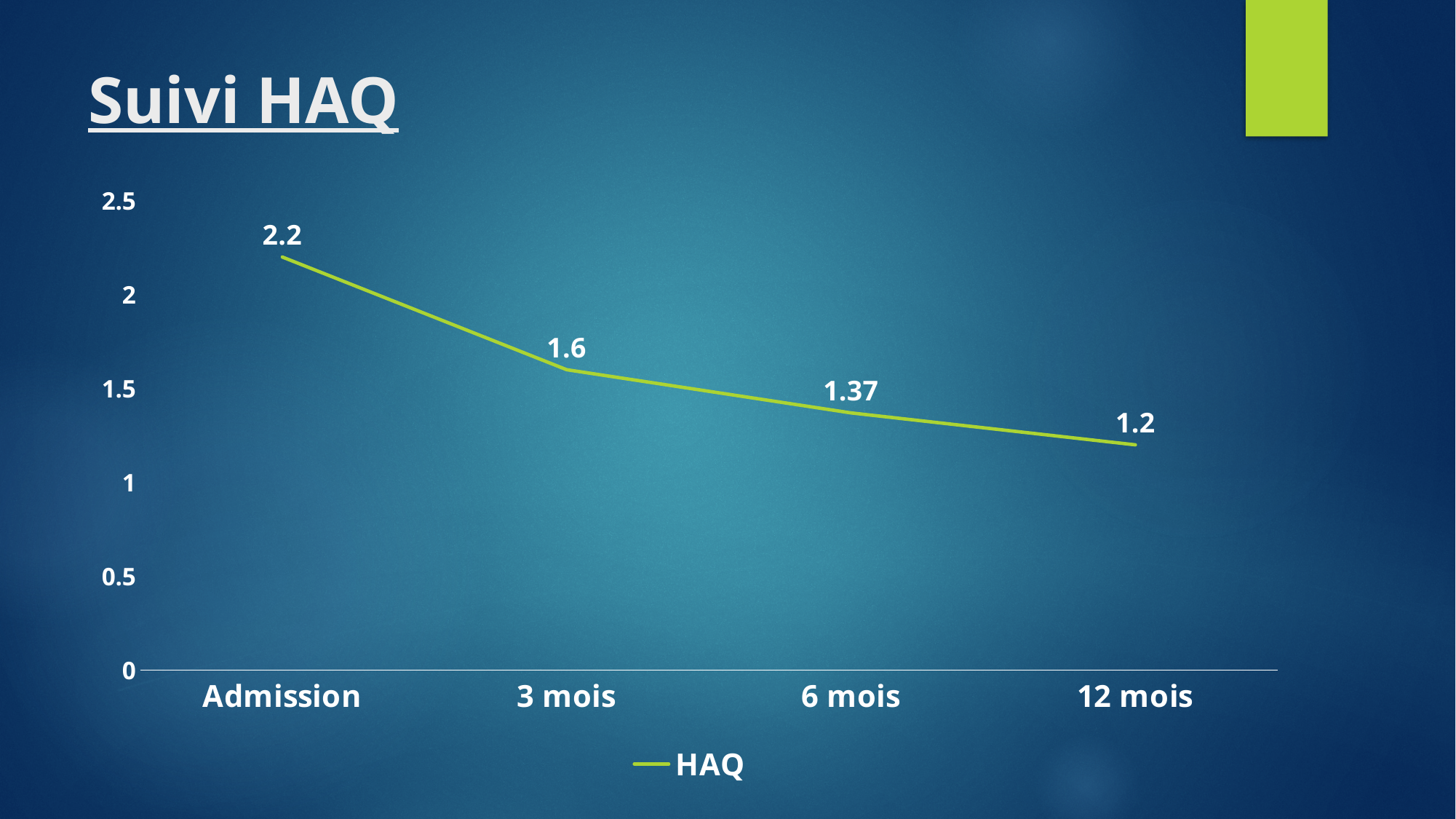
At which time point is the HAQ value lowest? 12 mois What is the HAQ value at 6 mois? 1.37 What is the HAQ value at 12 mois? 1.2 What is the HAQ value at 3 mois? 1.6 Which is larger, the HAQ value at 3 mois or at 6 mois? 3 mois How many time points are plotted on the chart? 4 What kind of chart is shown on the slide? Line chart What is the difference between the HAQ value at Admission and at 12 mois? 1 At which time point is the HAQ value highest? Admission How many series does the legend list? 1 What is the HAQ value at Admission? 2.2 Do the HAQ values rise or fall from Admission to 12 mois? Fall